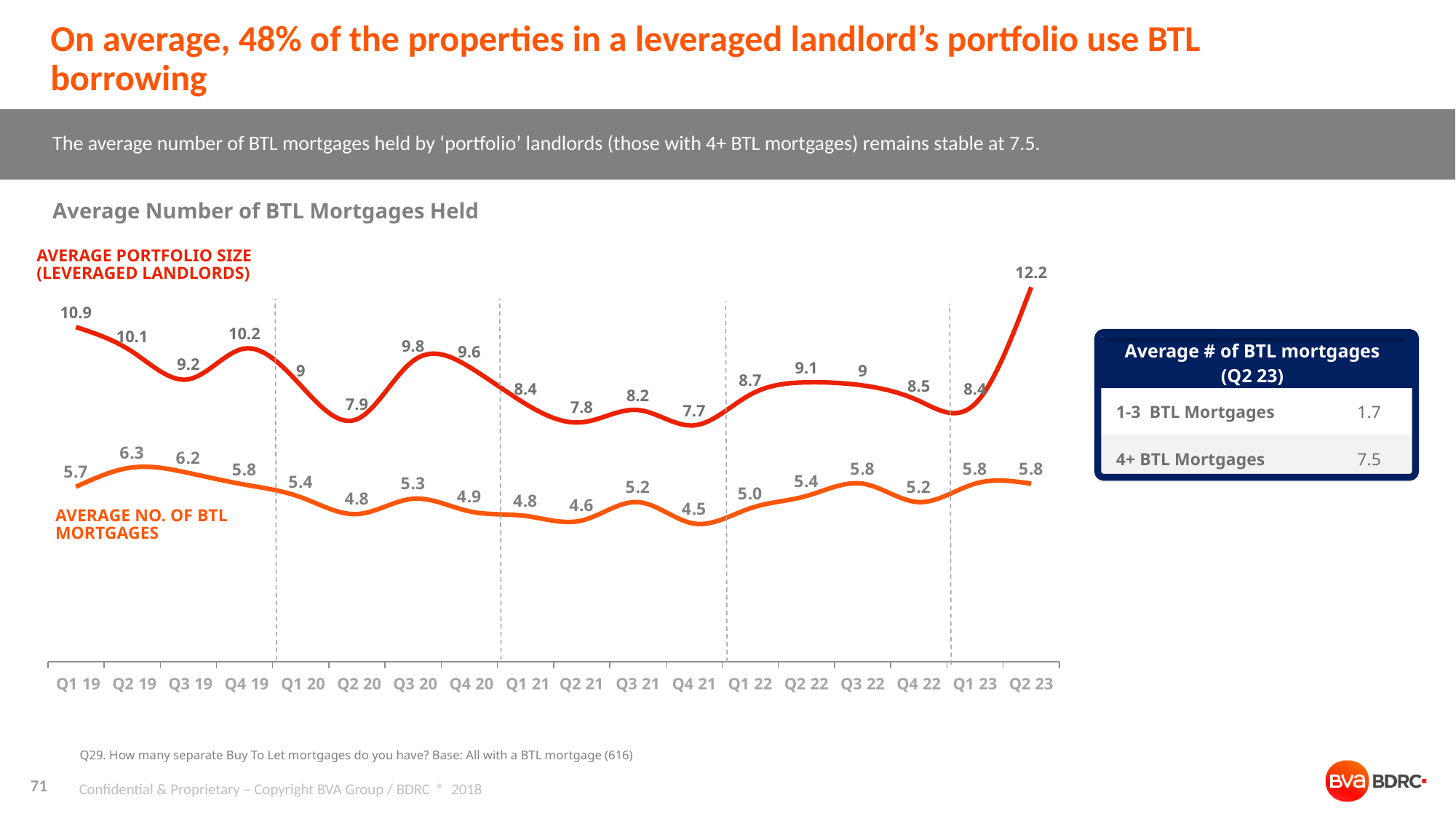
What is the difference between the average portfolio size and the average number of BTL mortgages in Q2 23? 6.4 In which quarter is the average number of BTL mortgages lowest? Q4 21 How many quarters are plotted on the x axis? 18 Which is larger: the average portfolio size in Q1 19 or in Q4 19? Q1 19 In which quarter is the average number of BTL mortgages highest? Q2 19 What is the title of the chart? Average Number of BTL Mortgages Held What type of chart is shown on the slide? Line chart What is the average portfolio size for leveraged landlords in Q2 23? 12.2 In which quarter is the average portfolio size for leveraged landlords highest? Q2 23 What is the average number of BTL mortgages in Q4 21? 4.5 What is the average portfolio size for leveraged landlords in Q2 20? 7.9 How many data series are plotted on the chart? 2